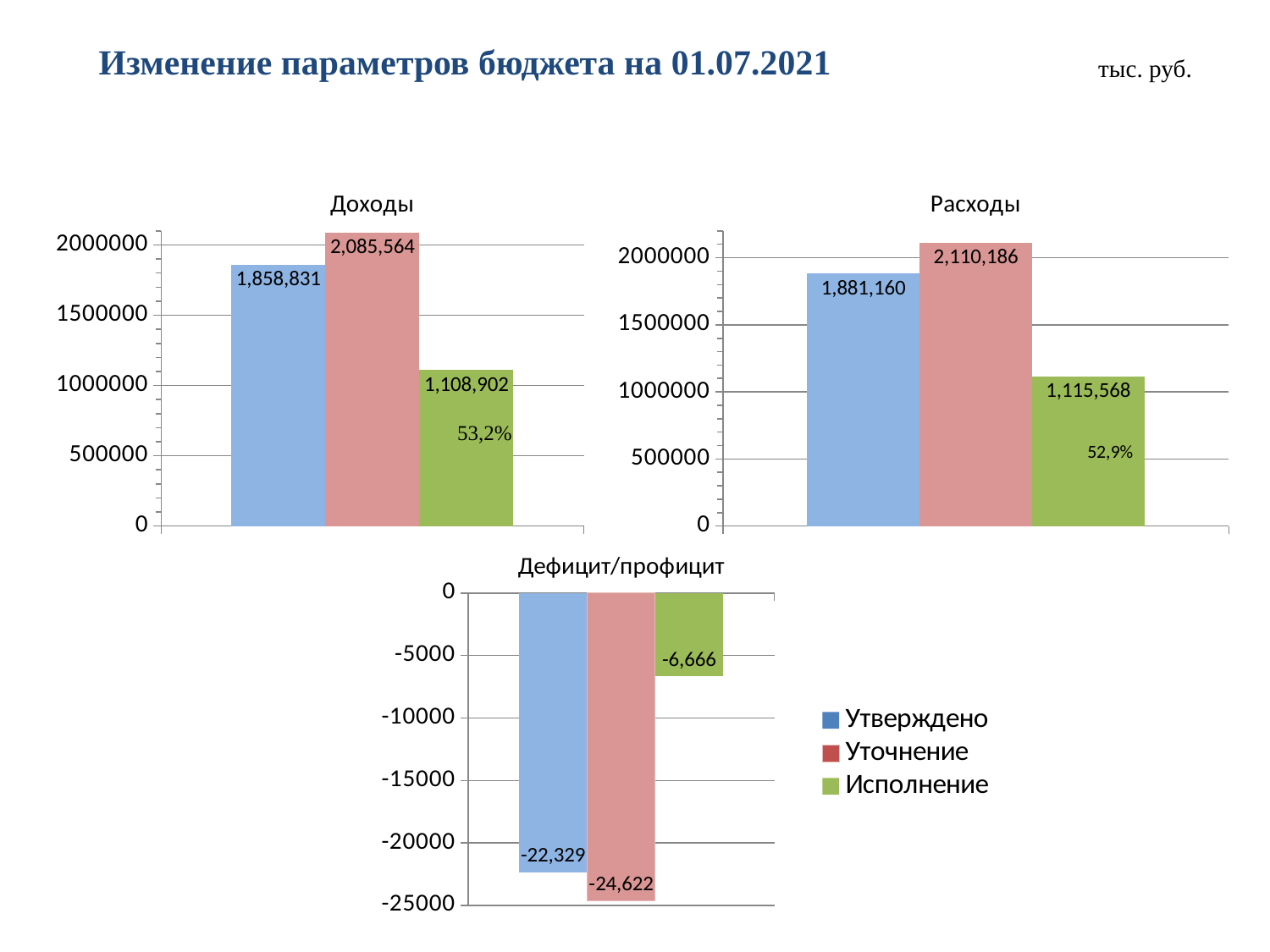
In the "Доходы" chart, which series has the highest value? Уточнение What type of chart is the "Расходы" chart? Bar chart In the "Дефицит/профицит" chart, what is the value for Исполнение? -6,666 In the "Расходы" chart, which series has the lowest value? Исполнение How many bars are plotted in the "Дефицит/профицит" chart? 3 In the "Доходы" chart, what is the value for Уточнение? 2,085,564 How many series does the legend list? 3 In the "Расходы" chart, is the value for Исполнение greater or less than 1000000? greater In the "Расходы" chart, what is the value for Утверждено? 1,881,160 In the "Дефицит/профицит" chart, which is larger in magnitude: Утверждено or Уточнение? Уточнение In the "Доходы" chart, what is the difference between the Уточнение and Утверждено values? 226,733 What percentage label is shown on the Исполнение bar in the "Доходы" chart? 53,2%